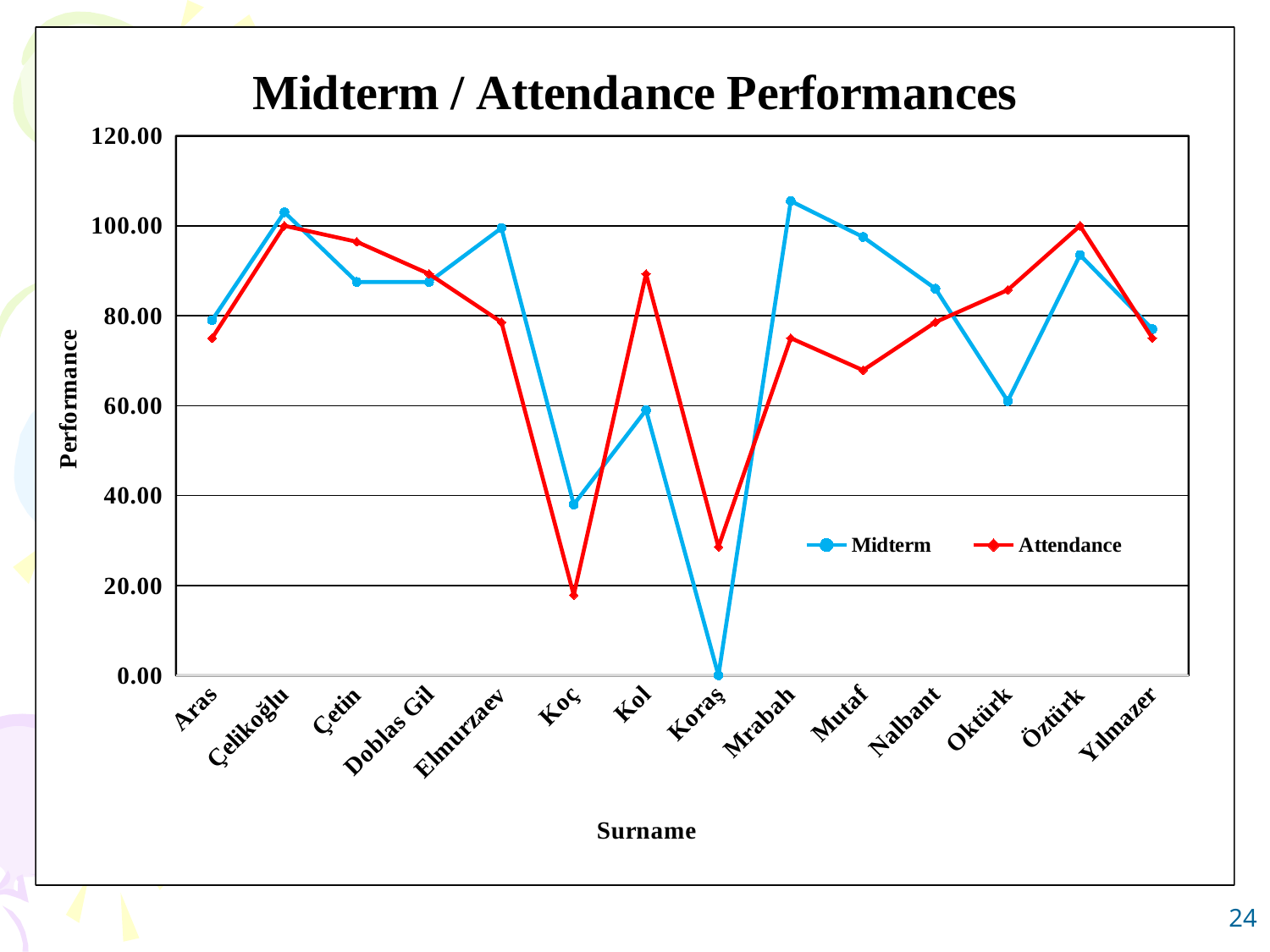
How many series does the legend list? 2 How many surnames are plotted along the x axis? 14 What is the Midterm value for Koraş? 0.00 Which surname has the lowest Midterm value? Koraş Which surname has the highest Midterm value? Mrabah Is the Midterm value for Mrabah greater or less than 100.00? greater Is the Midterm value for Koç greater or less than 40.00? less What is the title of the chart? Midterm / Attendance Performances Is the Attendance value for Koraş greater or less than 40.00? less For Kol, which is larger: the Midterm value or the Attendance value? Attendance What kind of chart is shown on the slide? Line chart Which surname has the lowest Attendance value? Koç